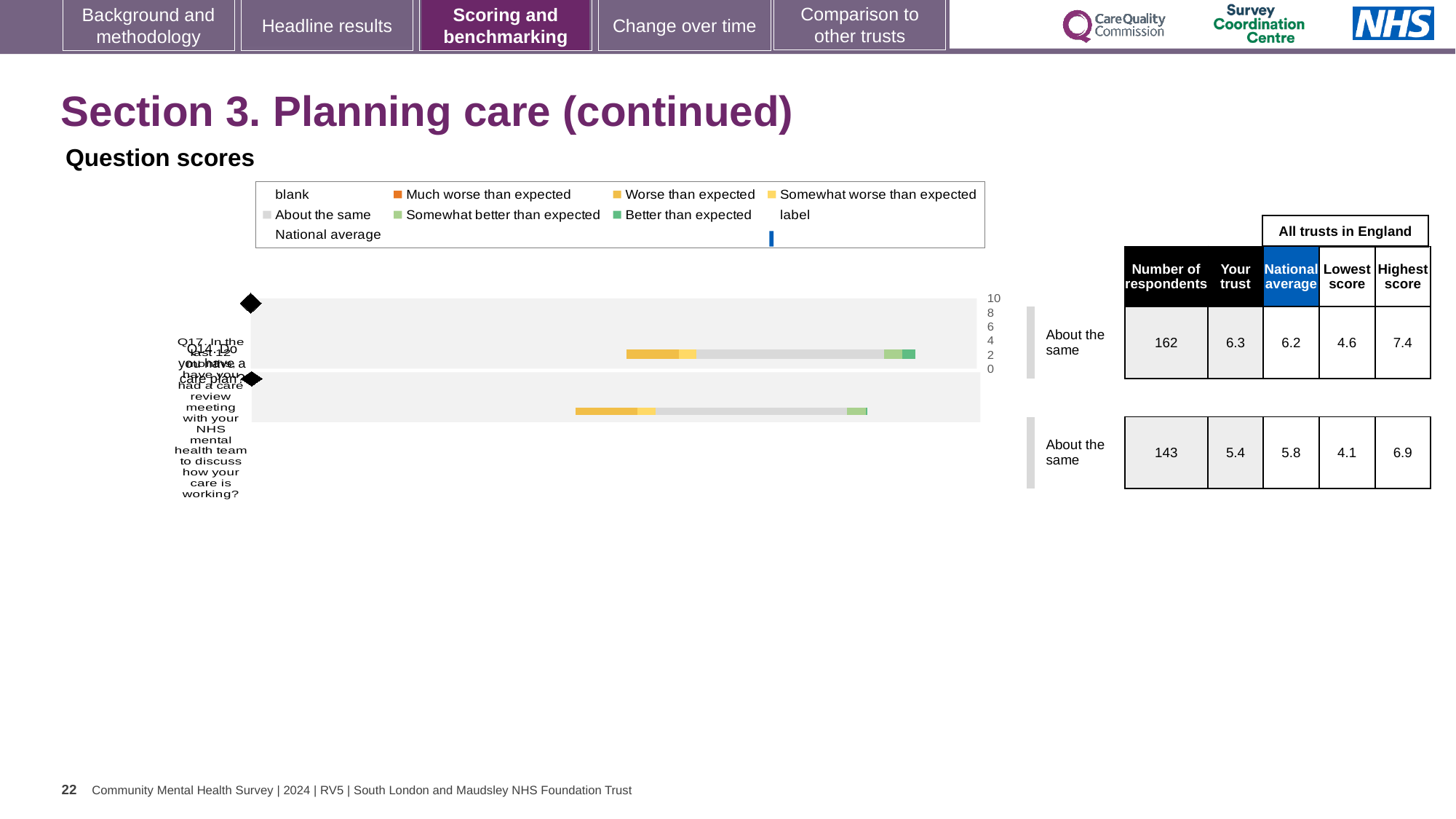
What is the 'Your trust' score for the top question row (162 respondents)? 6.3 How many question rows are plotted in the chart? 2 What is the maximum value shown on the chart's score axis? 10 How many respondents answered the bottom question row? 143 What kind of chart is used to show the question scores on this slide? bar chart Which is larger for the bottom question row: the trust's score or the national average? national average What is the highest score among all trusts in England for the bottom question row (143 respondents)? 6.9 What is the lowest score among all trusts in England for the top question row (162 respondents)? 4.6 What is the national average for the top question row (162 respondents)? 6.2 What benchmark category is given for both question rows? About the same What is the 'Your trust' score for the bottom question row (143 respondents)? 5.4 What is the difference between the highest and lowest scores for the top question row (7.4 and 4.6)? 2.8